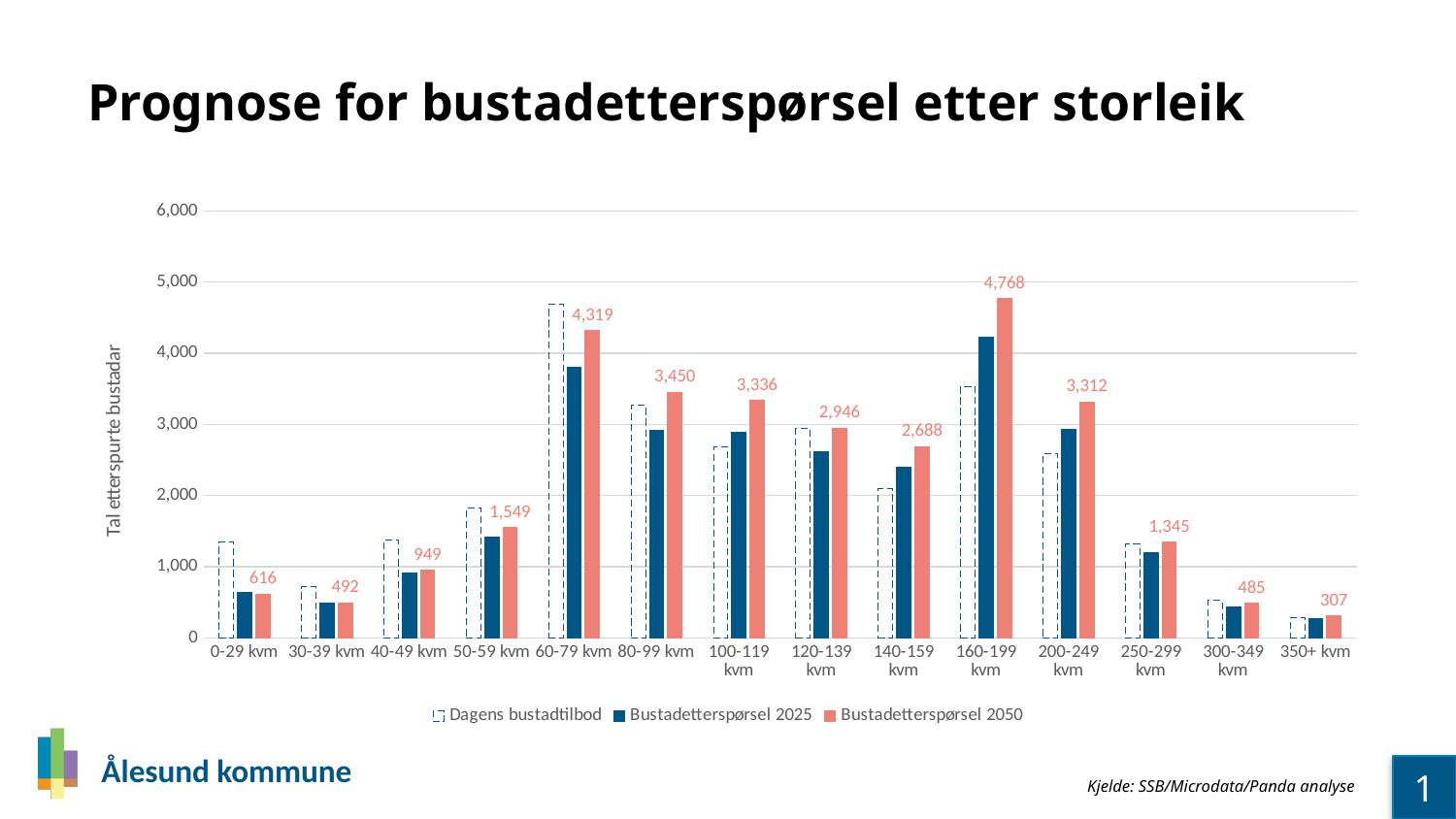
Which is larger for Bustadetterspørsel 2050: 80-99 kvm or 100-119 kvm? 80-99 kvm Which size category has the highest Bustadetterspørsel 2050 value? 160-199 kvm How many size categories are shown on the x axis? 14 Which size category has the lowest Bustadetterspørsel 2050 value? 350+ kvm How many series does the legend list? 3 What is the difference between the Bustadetterspørsel 2050 values for 160-199 kvm and 60-79 kvm? 449 Is the Dagens bustadtilbod value for 140-159 kvm greater or less than 3,000? less What is the Bustadetterspørsel 2050 value for 60-79 kvm? 4,319 What is the Bustadetterspørsel 2050 value for 0-29 kvm? 616 What is the Bustadetterspørsel 2050 value for 160-199 kvm? 4,768 What kind of chart is shown on the slide? Bar chart Is the Bustadetterspørsel 2025 value for 160-199 kvm greater or less than 4,000? greater